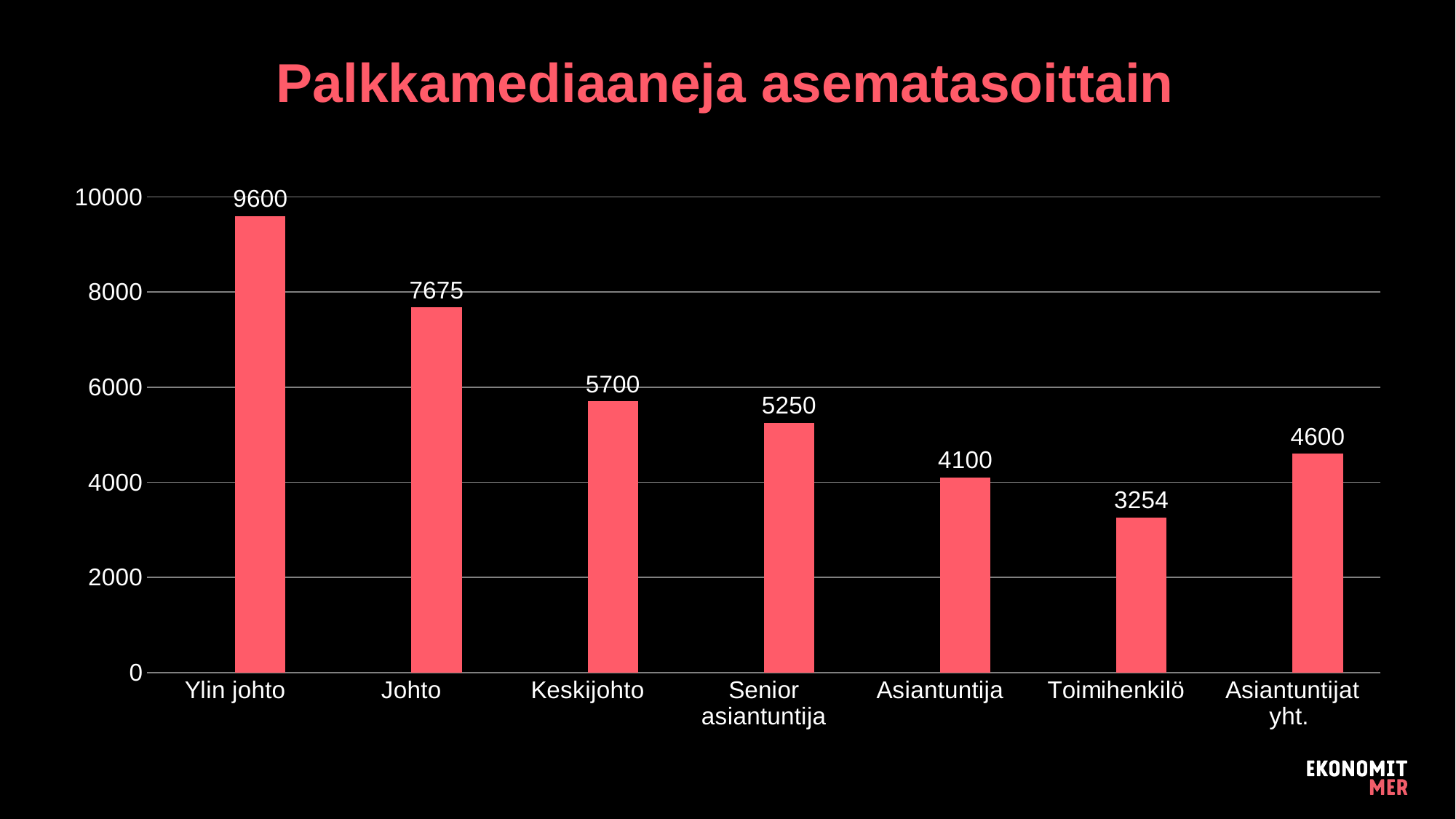
What is the title of the chart? Palkkamediaaneja asematasoittain How many categories are shown on the x axis? 7 What is the value for Toimihenkilö? 3254 What is the value for Ylin johto? 9600 What is the difference between the values for Johto and Keskijohto? 1975 Is the value for Keskijohto greater or less than 6000? less What is the value for Asiantuntijat yht.? 4600 What kind of chart is shown on the slide? bar chart What is the value for Senior asiantuntija? 5250 Which category has the lowest value? Toimihenkilö Which category has the highest value? Ylin johto Which is larger, the value for Asiantuntija or the value for Asiantuntijat yht.? Asiantuntijat yht.